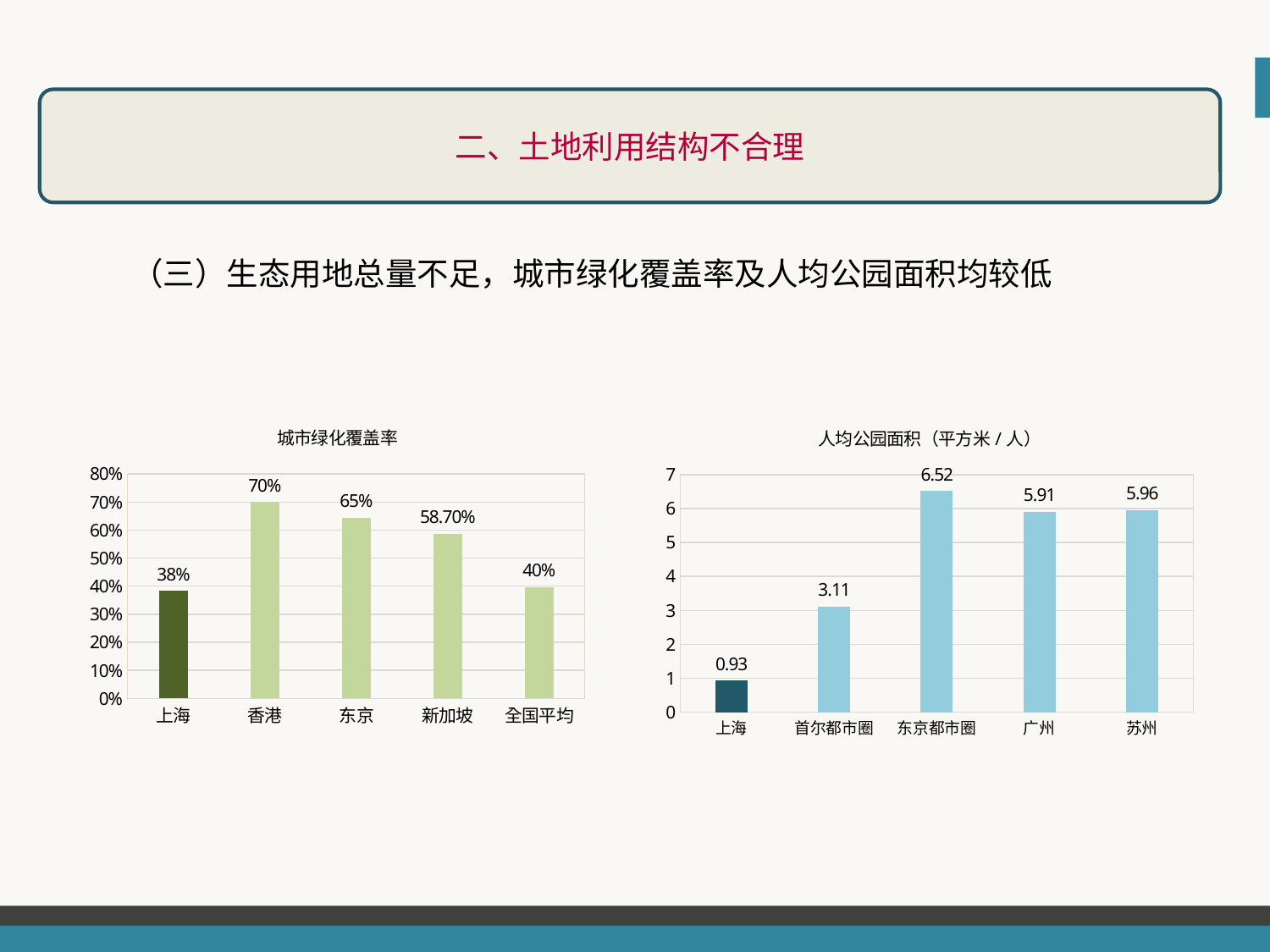
In the 城市绿化覆盖率 chart, what is the value for 上海? 38% In the 城市绿化覆盖率 chart, which category has the highest value? 香港 In the 城市绿化覆盖率 chart, what is the difference between 香港 and 上海? 32% In the 城市绿化覆盖率 chart, which bar is shown in a darker green colour than the others? 上海 What kind of chart is the 人均公园面积（平方米 / 人） chart? bar chart In the 人均公园面积（平方米 / 人） chart, what is the difference between 东京都市圈 and 上海? 5.59 In the 人均公园面积（平方米 / 人） chart, what is the value for 首尔都市圈? 3.11 In the 城市绿化覆盖率 chart, what is the value for 新加坡? 58.70% In the 城市绿化覆盖率 chart, how many categories are shown? 5 In the 人均公园面积（平方米 / 人） chart, which is larger, 广州 or 苏州? 苏州 In the 人均公园面积（平方米 / 人） chart, which category has the highest value? 东京都市圈 In the 城市绿化覆盖率 chart, which category has the lowest value? 上海